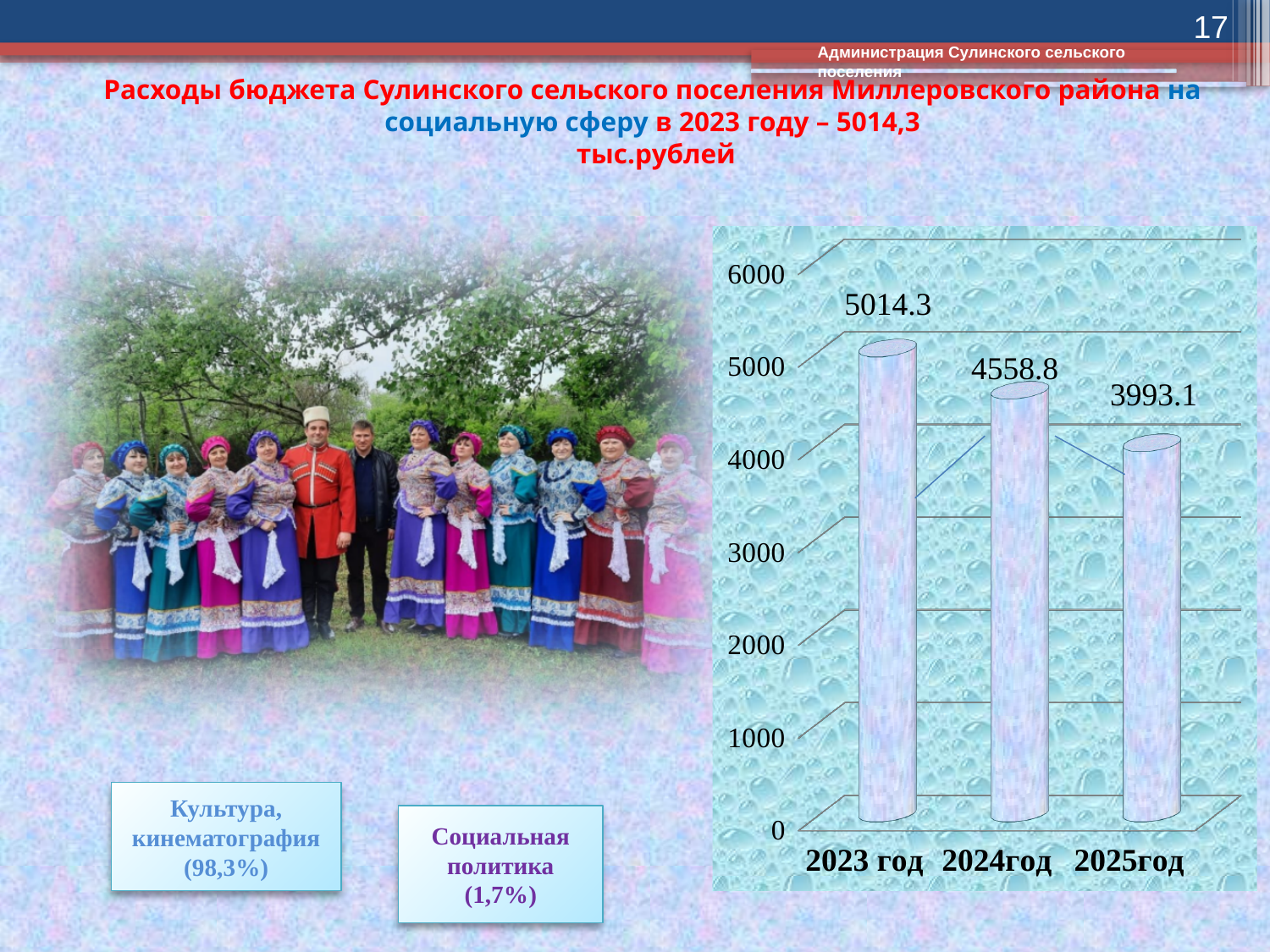
Do the values rise or fall from 2023 год to 2025год? fall Which is larger, the value for 2023 год or the value for 2025год? 2023 год How many categories (years) are shown on the x axis of the chart? 3 Which year has the highest value in the chart? 2023 год What is the difference between the values for 2023 год and 2024год? 455.5 What kind of chart is shown on the slide? bar chart Is the value for 2025год greater or less than 4000? less What is the value shown for 2025год? 3993.1 What is the value shown for 2024год? 4558.8 What is the difference between the values for 2024год and 2025год? 565.7 Which year has the lowest value in the chart? 2025год What is the value shown for 2023 год? 5014.3